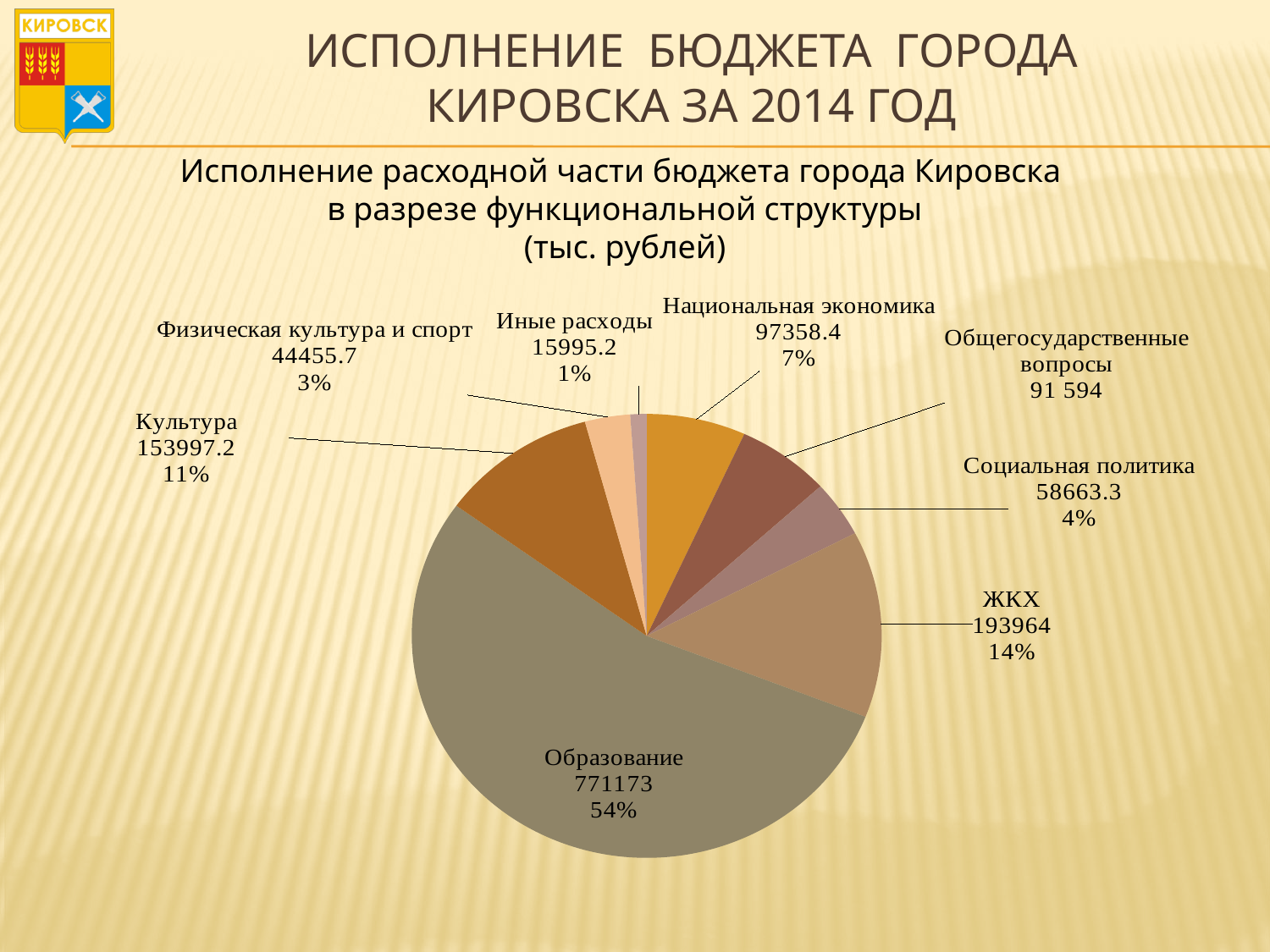
What share of the pie does Образование take? 54% What share of the pie does Национальная экономика take? 7% What is the value for Общегосударственные вопросы? 91 594 What is the value for ЖКХ? 193964 Which category has the largest slice of the pie? Образование What is the value for Культура? 153997.2 Which is larger, ЖКХ or Культура? ЖКХ Which category has the smallest slice of the pie? Иные расходы What kind of chart is shown on the slide? pie chart How many categories does the pie chart show? 8 What is the value for Образование? 771173 What is the difference between the values for ЖКХ and Культура? 39966.8